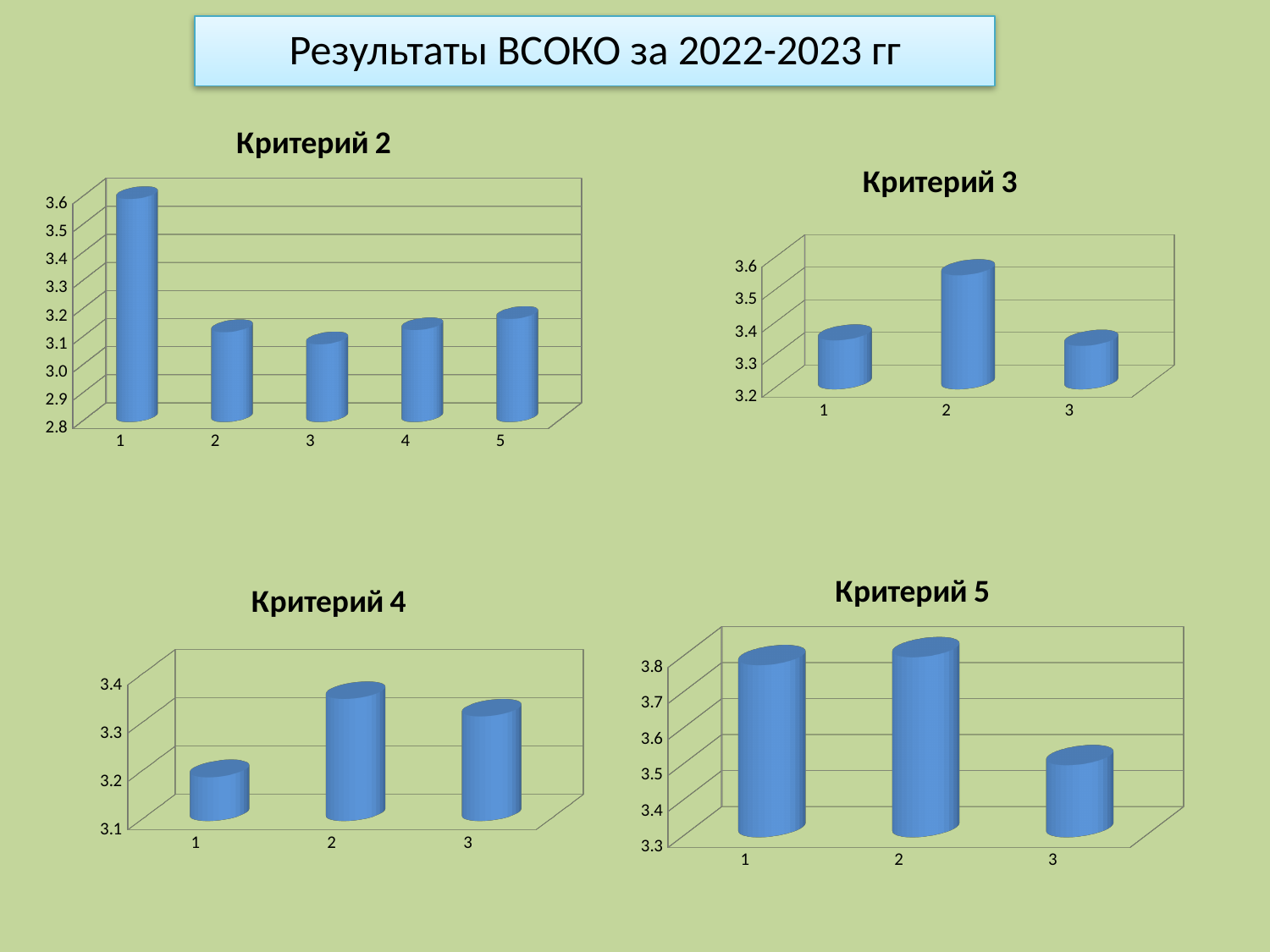
In the chart titled Критерий 5, is the value for category 1 greater or less than 3.6? greater What kind of chart is the chart titled Критерий 5? bar chart In the chart titled Критерий 4, which category has the lowest value? 1 In the chart titled Критерий 3, which category has the highest value? 2 In the chart titled Критерий 4, is the value for category 1 greater or less than 3.3? less How many categories are shown in the chart titled Критерий 2? 5 In the chart titled Критерий 2, which category has the highest value? 1 In the chart titled Критерий 3, is the value for category 2 greater or less than 3.4? greater In the chart titled Критерий 5, which category has the lowest value? 3 How many charts are shown on the slide? 4